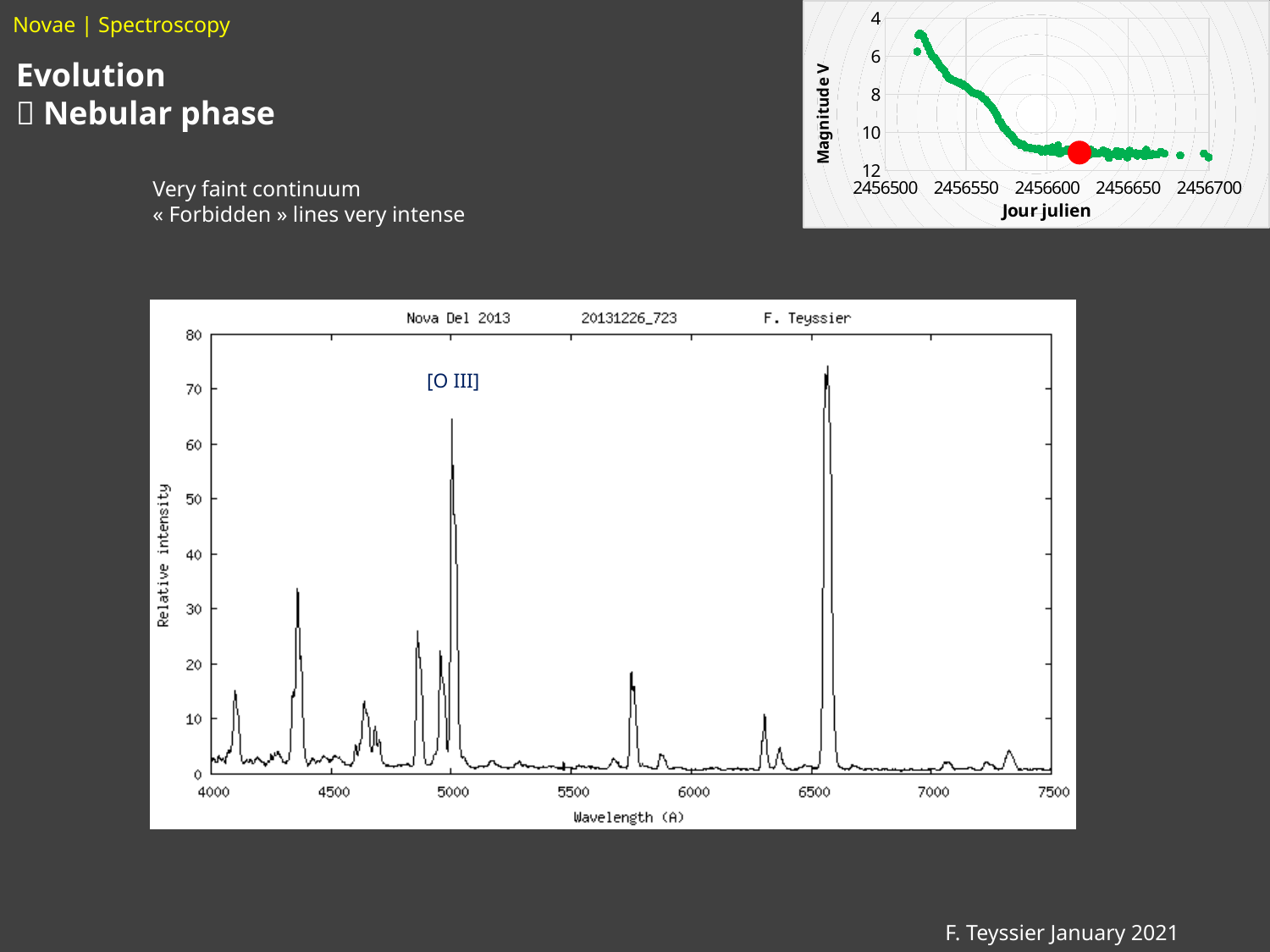
In the top-right chart, do the Magnitude V values increase or decrease as Jour julien increases? increase In the top-right chart, what is the label of the x axis? Jour julien In the top-right chart, is the Magnitude V value at Jour julien 2456700 greater or less than 10? greater In the bottom chart 'Nova Del 2013', which peak is taller: the one near 6550 A or the [O III] peak near 5000 A? the one near 6550 A In the top-right chart, what is the label of the y axis? Magnitude V In the bottom chart 'Nova Del 2013', is the relative intensity of the [O III] peak near 5000 A greater or less than 60? greater In the bottom chart 'Nova Del 2013', what is the label of the x axis? Wavelength (A) In the bottom chart 'Nova Del 2013', is the relative intensity of the tallest peak near 6550 A greater or less than 70? greater What kind of chart is the bottom chart titled 'Nova Del 2013'? line chart